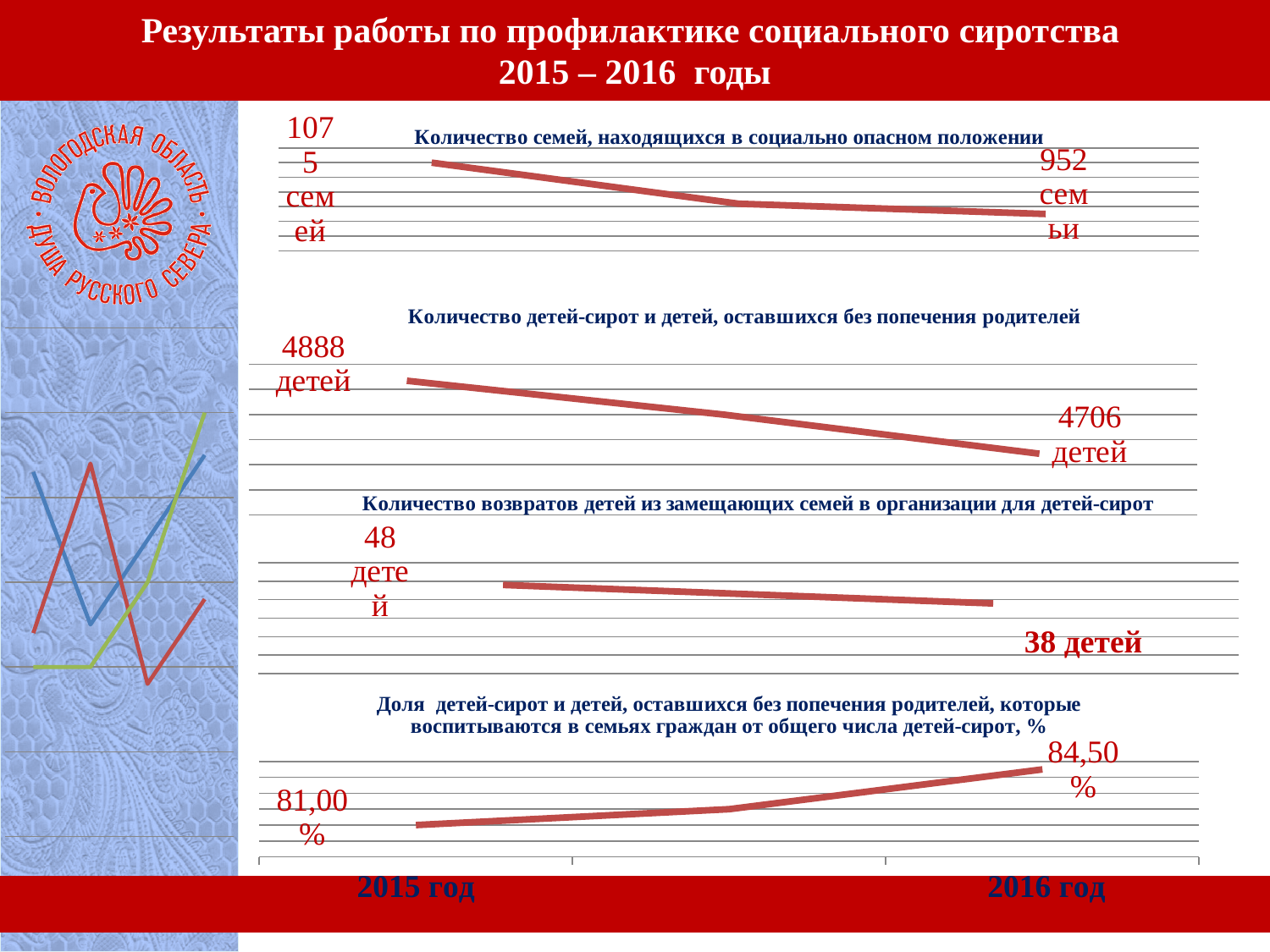
In the chart 'Доля детей-сирот и детей, оставшихся без попечения родителей, которые воспитываются в семьях граждан...', does the value rise or fall from 2015 to 2016? rise What type of chart is used for 'Количество детей-сирот и детей, оставшихся без попечения родителей'? line chart In the chart 'Количество семей, находящихся в социально опасном положении', does the value rise or fall from 2015 to 2016? fall In the chart 'Количество семей, находящихся в социально опасном положении', what is the value for 2015 год? 1075 семей In the chart 'Количество возвратов детей из замещающих семей в организации для детей-сирот', what is the value for 2015 год? 48 детей In the chart 'Количество возвратов детей из замещающих семей в организации для детей-сирот', which year has the higher value, 2015 or 2016? 2015 год In the chart 'Количество семей, находящихся в социально опасном положении', what is the value for 2016 год? 952 семьи In the chart 'Количество возвратов детей из замещающих семей в организации для детей-сирот', what is the difference between the 2015 and 2016 values? 10 In the chart 'Количество детей-сирот и детей, оставшихся без попечения родителей', what is the value for 2016 год? 4706 детей How many data points are plotted in the chart 'Количество семей, находящихся в социально опасном положении'? 3 In the chart 'Доля детей-сирот и детей, оставшихся без попечения родителей, которые воспитываются в семьях граждан...', what is the value for 2016 год? 84,50 % In the chart 'Количество детей-сирот и детей, оставшихся без попечения родителей', by how much did the number of children fall from 2015 to 2016? 182